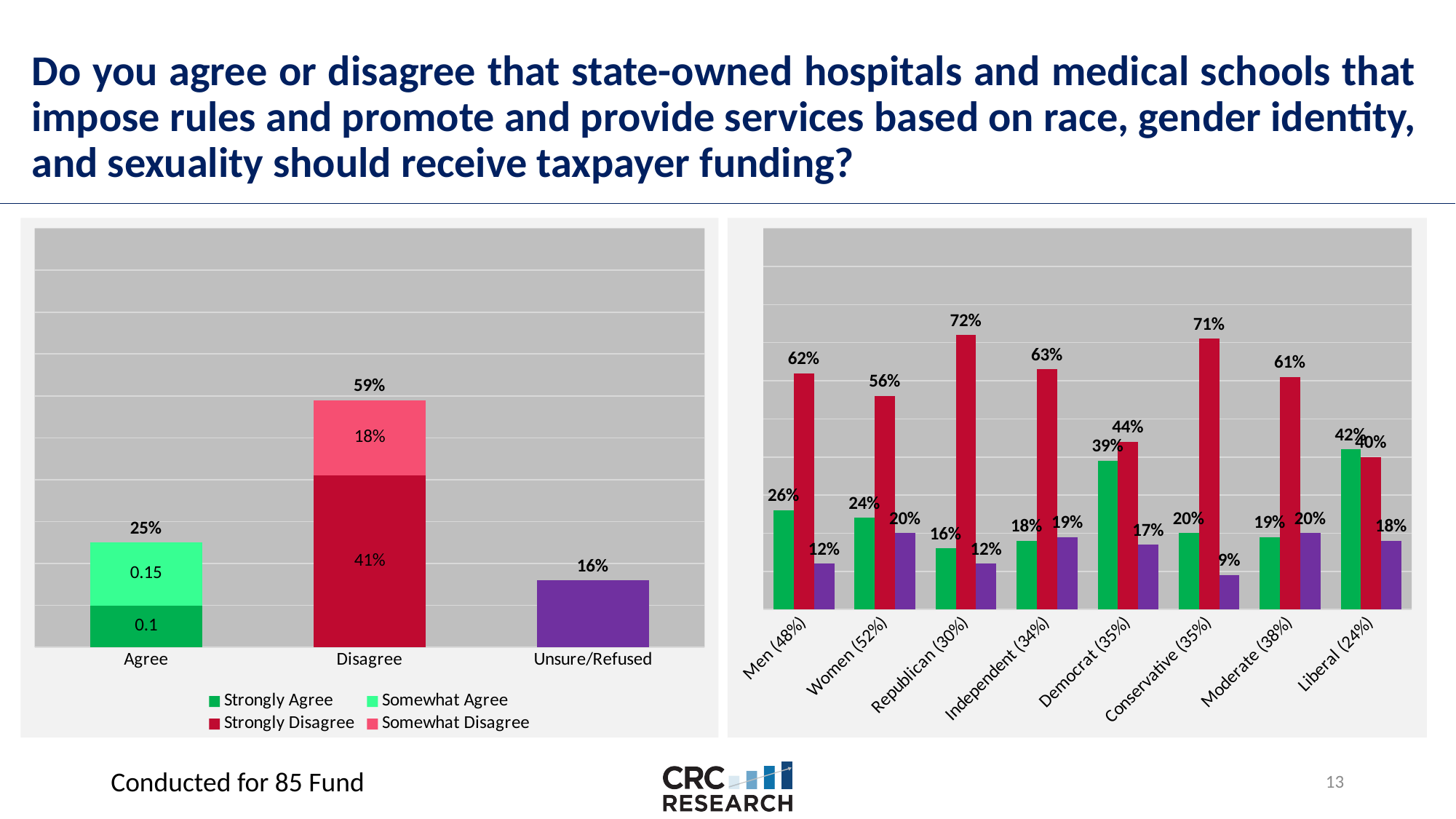
On the left chart, what value is shown for Unsure/Refused? 16% On the right chart, which category has the highest green bar? Liberal (24%) On the left chart, how many series does the legend list? 4 On the right chart, which category has the lowest purple bar? Conservative (35%) What kind of chart is the chart on the right? bar chart On the left chart, what is the total value shown for the Disagree bar? 59% On the left chart, what is the difference between the Disagree total and the Agree total? 34% On the right chart, what is the value of the green bar for Democrat (35%)? 39% On the right chart, is the red bar for Men (48%) larger or smaller than the red bar for Women (52%)? larger On the left chart, what is the Strongly Disagree portion of the Disagree bar? 41% On the right chart, what is the value of the red bar for Republican (30%)? 72% On the right chart, how many categories are shown on the x axis? 8